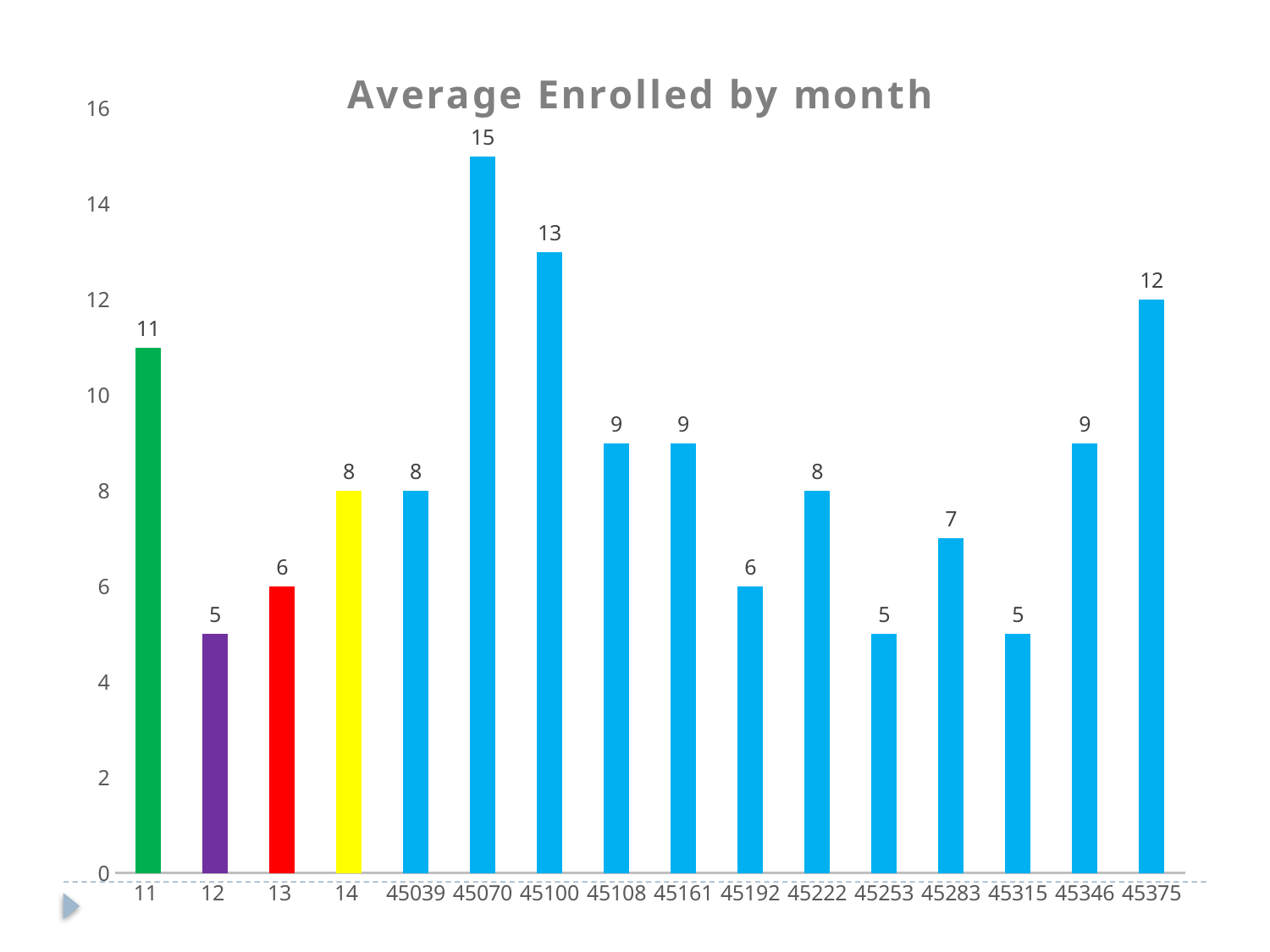
What is the value for category 45375? 12 Which has a larger value, category 11 or category 45375? 45375 What colour is the bar for category 13? red Which category has the highest value? 45070 What is the difference between the values for 45070 and 45100? 2 What is the lowest value shown in the chart? 5 How many bars are plotted in the chart? 16 What is the value for category 45283? 7 What is the value for category 11? 11 What kind of chart is shown on the slide? bar chart What is the value for category 45070? 15 What is the title of the chart? Average Enrolled by month